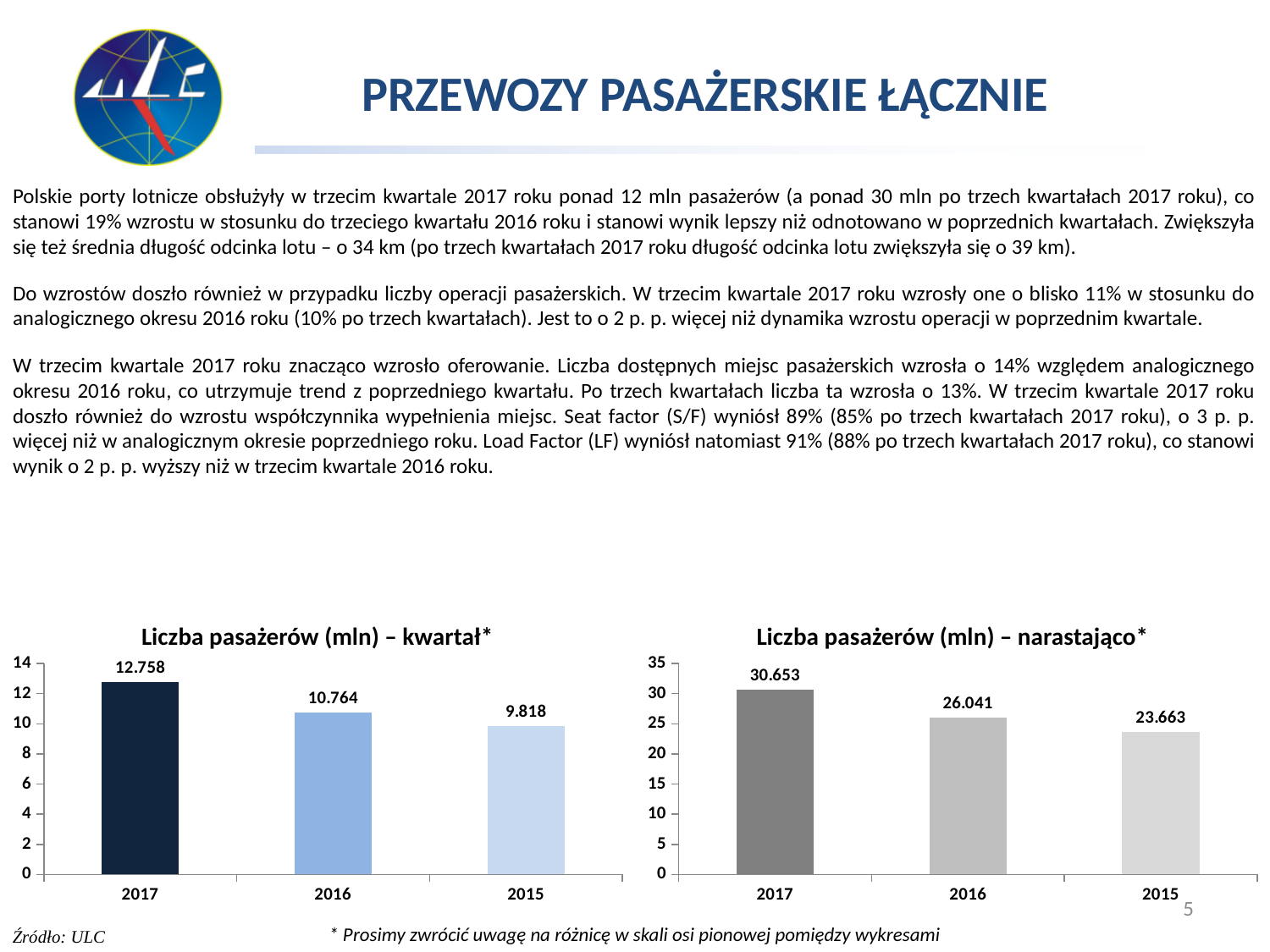
In the chart 'Liczba pasażerów (mln) – kwartał*', is the value for 2016 greater or less than 10? greater In the chart 'Liczba pasażerów (mln) – kwartał*', what is the value for 2015? 9.818 What type of chart is 'Liczba pasażerów (mln) – kwartał*'? bar chart In the chart 'Liczba pasażerów (mln) – narastająco*', is the value for 2016 larger or smaller than the value for 2015? larger In the chart 'Liczba pasażerów (mln) – kwartał*', what is the difference between the values for 2017 and 2016? 1.994 In the chart 'Liczba pasażerów (mln) – narastająco*', what is the value for 2016? 26.041 In the chart 'Liczba pasażerów (mln) – kwartał*', which year has the lowest value? 2015 How many bars are shown in the chart 'Liczba pasażerów (mln) – narastająco*'? 3 In the chart 'Liczba pasażerów (mln) – kwartał*', what is the value for 2017? 12.758 In the chart 'Liczba pasażerów (mln) – narastająco*', do the values rise or fall from left to right along the x axis? fall In the chart 'Liczba pasażerów (mln) – narastająco*', what is the difference between the values for 2017 and 2015? 6.990 In the chart 'Liczba pasażerów (mln) – narastająco*', which year has the highest value? 2017